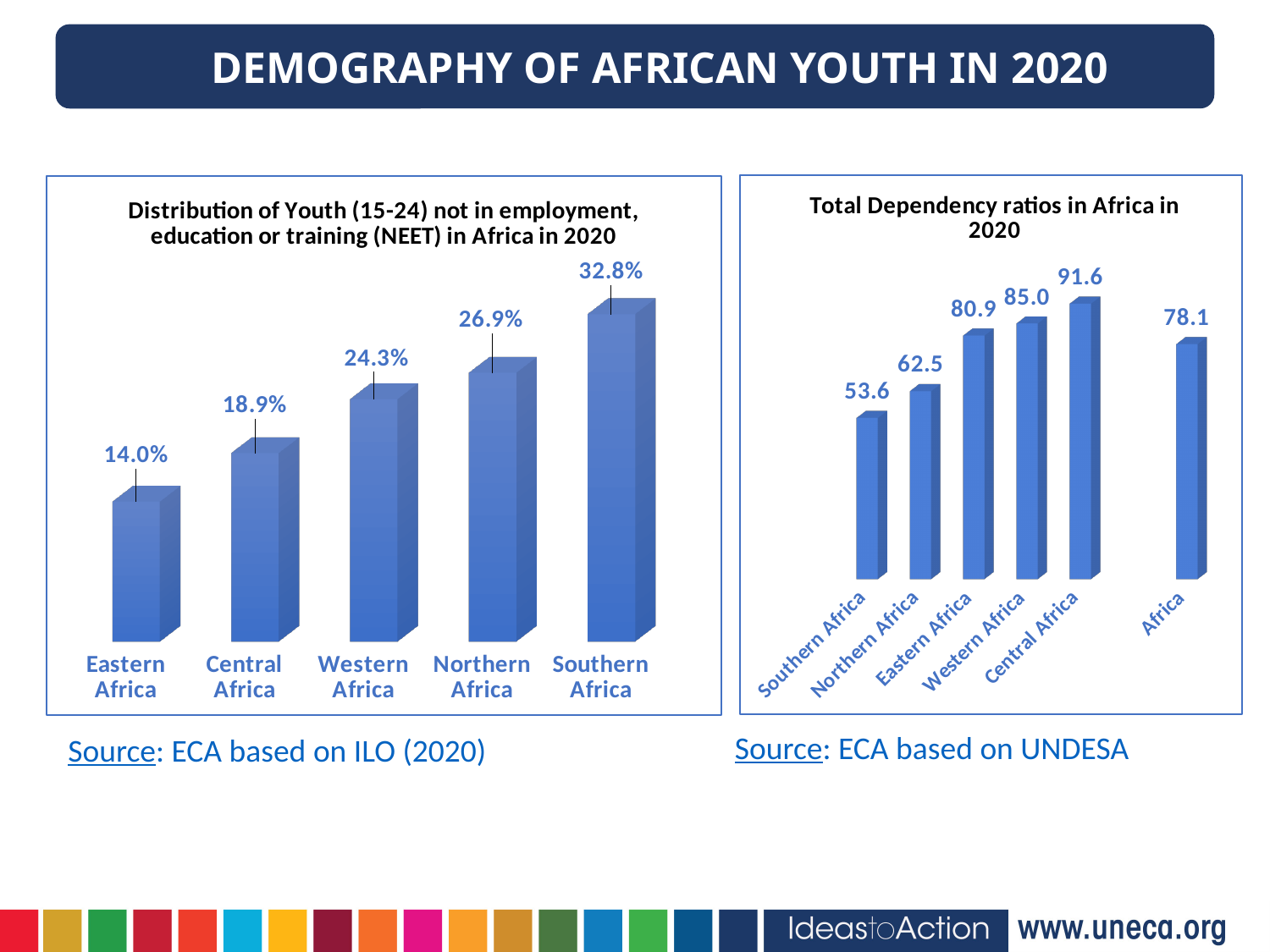
In the NEET distribution chart on the left, which region has the highest value? Southern Africa In the Total Dependency ratios chart on the right, what is the value for Northern Africa? 62.5 In the NEET distribution chart on the left, what is the value for Western Africa? 24.3% In the Total Dependency ratios chart on the right, what is the value for Africa as a whole? 78.1 In the Total Dependency ratios chart on the right, what is the difference between Central Africa and Southern Africa? 38.0 In the Total Dependency ratios chart on the right, which region has the highest dependency ratio? Central Africa In the NEET distribution chart on the left, do the values rise or fall from left to right? rise In the NEET distribution chart on the left, what is the difference between Southern Africa and Eastern Africa? 18.8% What type of chart is the Total Dependency ratios chart on the right? bar chart In the NEET distribution chart on the left, how many regions are shown? 5 In the Total Dependency ratios chart on the right, which is larger, Eastern Africa or Western Africa? Western Africa In the NEET distribution chart on the left, which region has the lowest value? Eastern Africa